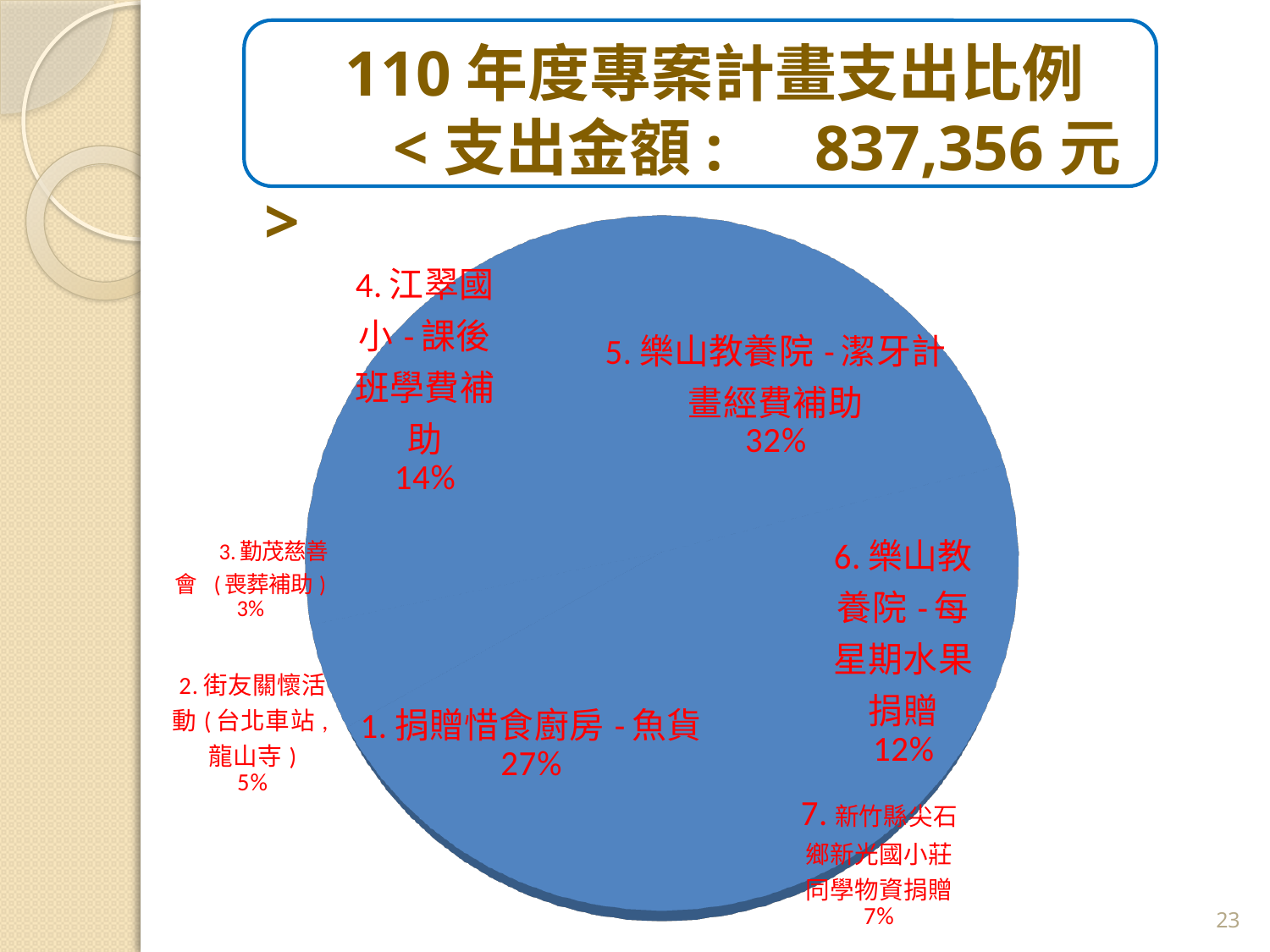
What share of the pie does 4. 江翠國小-課後班學費補助 represent? 14% What is the difference in percentage points between 5. 樂山教養院-潔牙計畫經費補助 and 1. 捐贈惜食廚房-魚貨? 5 percentage points Which has a larger share: 6. 樂山教養院-每星期水果捐贈 or 2. 街友關懷活動(台北車站，龍山寺)? 6. 樂山教養院-每星期水果捐贈 How many categories (slices) does the pie chart show? 7 Which category has the smallest share of spending? 3. 勤茂慈善會（喪葬補助） What kind of chart is shown on the slide? pie chart What percentage of spending went to 1. 捐贈惜食廚房-魚貨? 27% Which category has the largest share of spending? 5. 樂山教養院-潔牙計畫經費補助 What total spending amount is stated in the chart title? 837,356 元 What is the combined share of 2. 街友關懷活動(台北車站，龍山寺) and 3. 勤茂慈善會（喪葬補助）? 8% What percentage is shown for 7. 新竹縣尖石鄉新光國小莊同學物資捐贈? 7% What percentage of spending went to 5. 樂山教養院-潔牙計畫經費補助? 32%